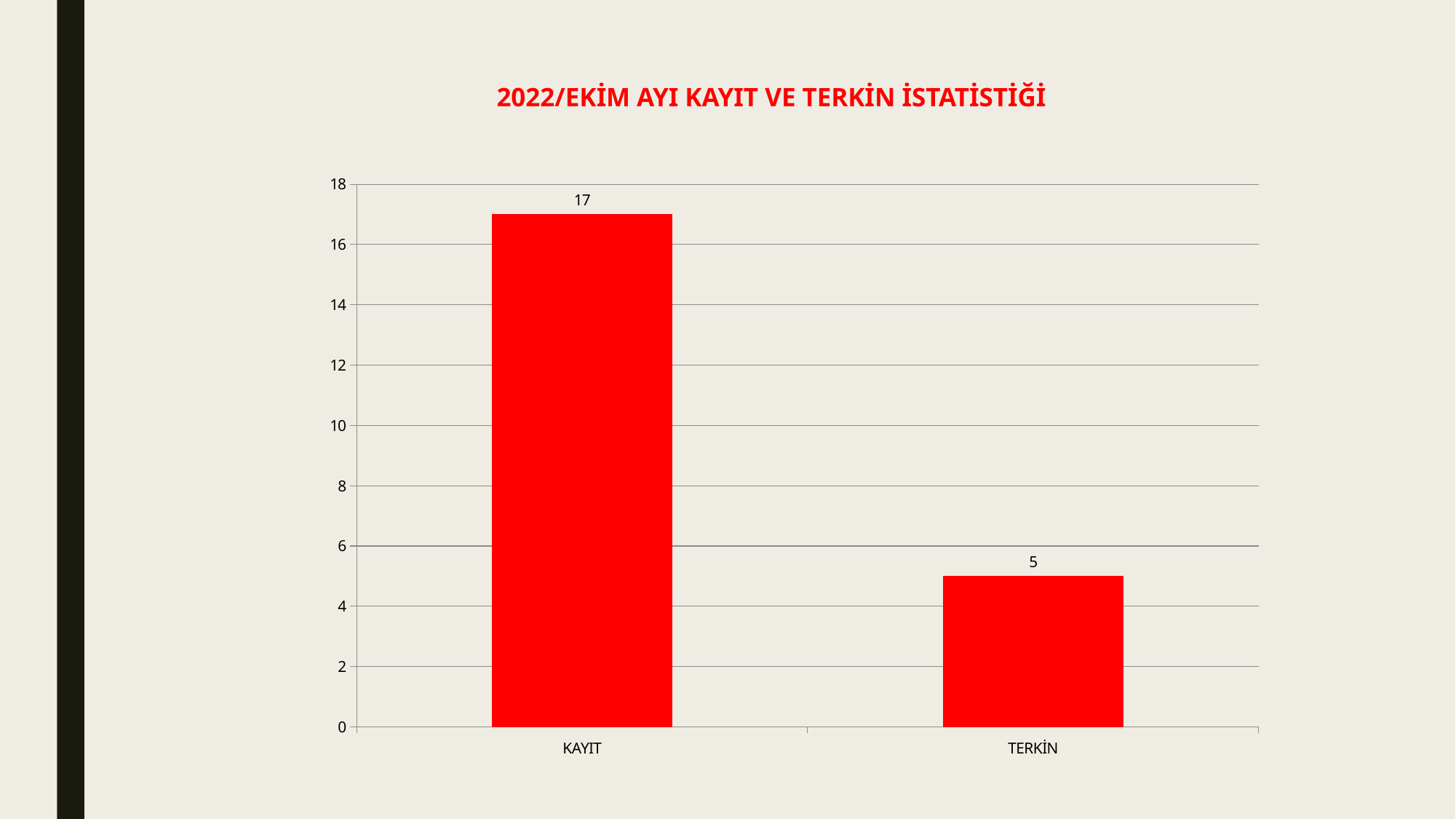
What is the title of the chart? 2022/EKİM AYI KAYIT VE TERKİN İSTATİSTİĞİ Which is larger, the value for KAYIT or the value for TERKİN? KAYIT What is the value for KAYIT? 17 What colour are the bars in the chart? red Is the value for TERKİN greater or less than 6? less What kind of chart is shown on the slide? bar chart What is the value for TERKİN? 5 What is the difference between the values for KAYIT and TERKİN? 12 How many categories are shown on the x axis? 2 Which category has the highest value? KAYIT Is the value for KAYIT greater or less than 10? greater Which category has the lowest value? TERKİN